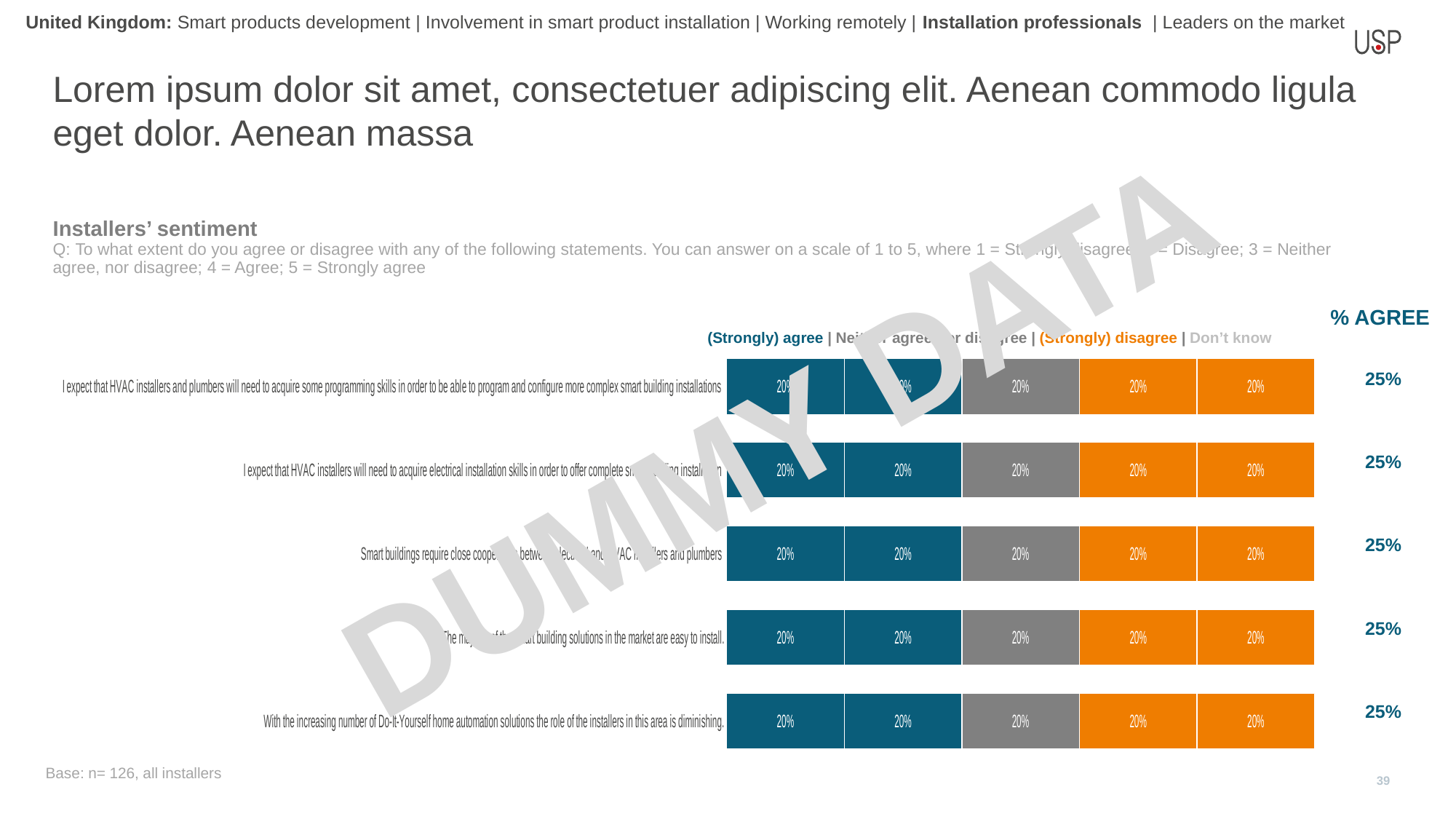
What is the value of the last (orange) segment of the bar for 'With the increasing number of Do-It-Yourself home automation solutions the role of the installers in this area is diminishing.'? 20% What is the % AGREE value for the statement 'I expect that HVAC installers and plumbers will need to acquire some programming skills in order to be able to program and configure more complex smart building installations'? 25% How many statements (bars) are shown in the chart? 5 Is the % AGREE value for the first statement larger than, smaller than, or equal to the % AGREE value for the last statement? Equal What is the base (sample size) stated below the chart? n= 126, all installers What is the difference between the first segment and the last segment of the bar for 'With the increasing number of Do-It-Yourself home automation solutions the role of the installers in this area is diminishing.'? 0% What is the value of the grey segment of the bar for 'Smart buildings require close cooperation between electrical and HVAC installers and plumbers'? 20% What is the % AGREE value for the statement 'With the increasing number of Do-It-Yourself home automation solutions the role of the installers in this area is diminishing.'? 25% What kind of chart is shown on the slide? Stacked bar chart What is the title of the chart? Installers' sentiment What is the value of the first (dark blue) segment of the bar for 'I expect that HVAC installers and plumbers will need to acquire some programming skills in order to be able to program and configure more complex smart building installations'? 20% What is the total of all segments in the bar for 'With the increasing number of Do-It-Yourself home automation solutions the role of the installers in this area is diminishing.'? 100%